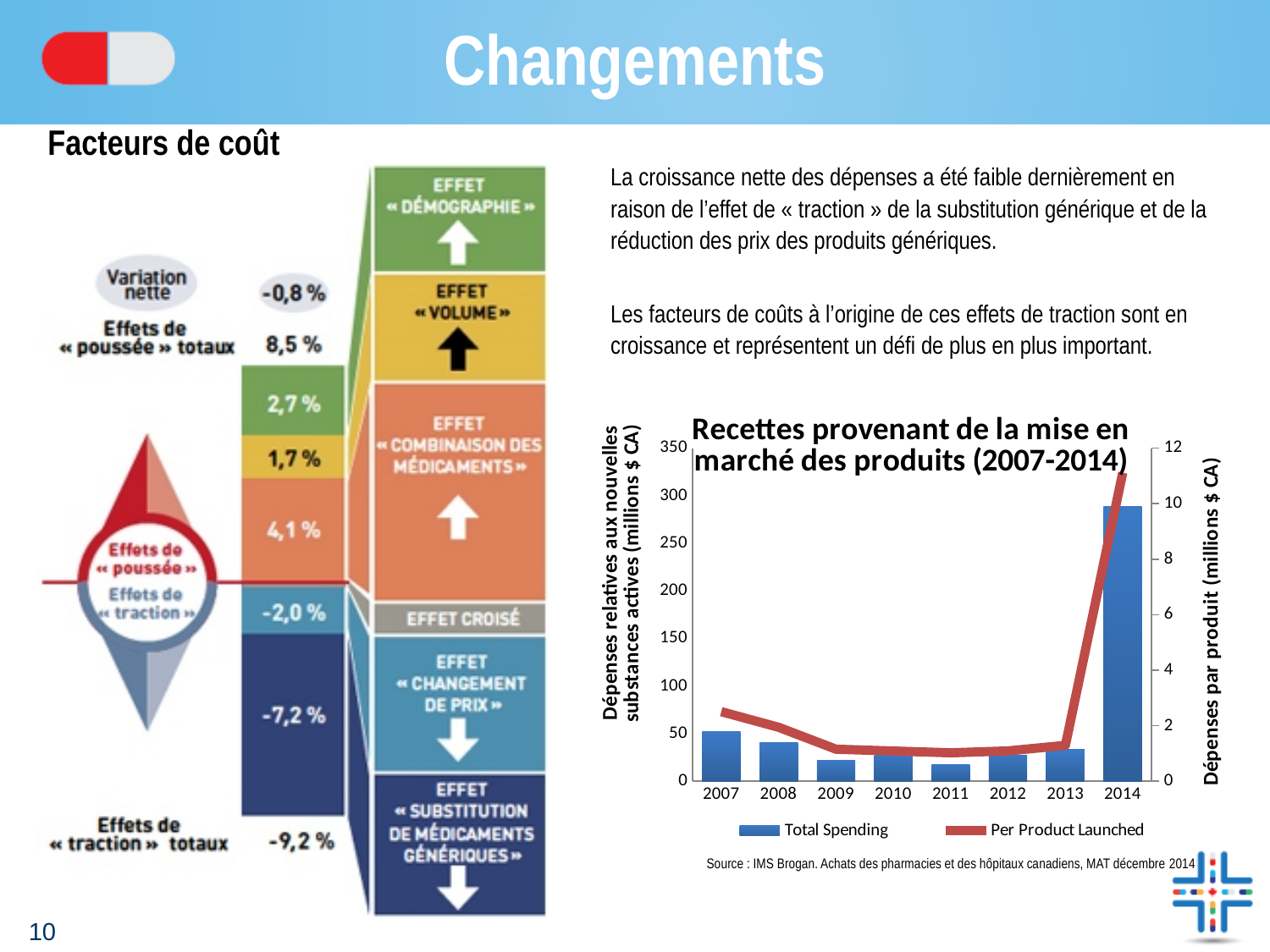
In the chart 'Recettes provenant de la mise en marché des produits (2007-2014)', is the Per Product Launched value for 2014 greater or less than 10? greater In the chart 'Recettes provenant de la mise en marché des produits (2007-2014)', which year has the highest Total Spending? 2014 In the chart 'Recettes provenant de la mise en marché des produits (2007-2014)', is the Per Product Launched value for 2011 greater or less than 2? less In the chart 'Recettes provenant de la mise en marché des produits (2007-2014)', is the Total Spending value for 2014 greater or less than 250? greater In the chart 'Recettes provenant de la mise en marché des produits (2007-2014)', which year has the larger Total Spending, 2007 or 2008? 2007 In the chart 'Recettes provenant de la mise en marché des produits (2007-2014)', which year has the lowest Total Spending? 2011 How many series does the legend of the chart 'Recettes provenant de la mise en marché des produits (2007-2014)' list? 2 What type of chart is used for the 'Total Spending' series in the chart 'Recettes provenant de la mise en marché des produits (2007-2014)'? bar chart In the chart 'Recettes provenant de la mise en marché des produits (2007-2014)', what colour is the 'Per Product Launched' line? red How many years are shown on the x axis of the chart 'Recettes provenant de la mise en marché des produits (2007-2014)'? 8 In the chart 'Recettes provenant de la mise en marché des produits (2007-2014)', does Total Spending rise or fall from 2007 to 2011? fall